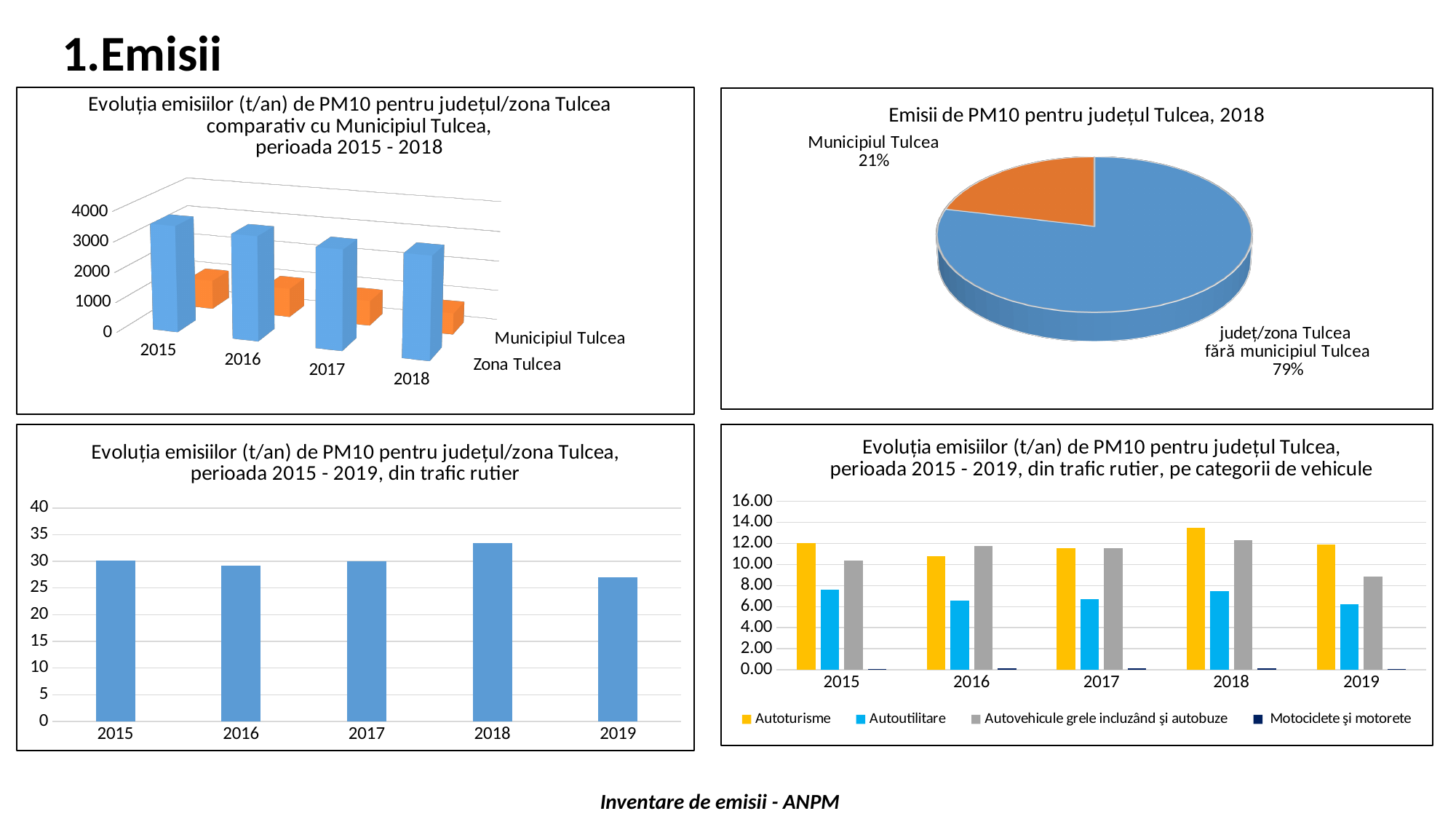
In the top-left chart 'Evoluția emisiilor (t/an) de PM10 pentru județul/zona Tulcea comparativ cu Municipiul Tulcea, perioada 2015 - 2018', which series is larger in 2015, Zona Tulcea or Municipiul Tulcea? Zona Tulcea In the bottom-right chart 'Evoluția emisiilor (t/an) de PM10 pentru județul Tulcea, perioada 2015 - 2019, din trafic rutier, pe categorii de vehicule', how many series does the legend list? 4 In the bottom-right chart 'Evoluția emisiilor (t/an) de PM10 pentru județul Tulcea, perioada 2015 - 2019, din trafic rutier, pe categorii de vehicule', is the Autoutilitare value for 2016 greater or less than 8.00? less In the pie chart 'Emisii de PM10 pentru județul Tulcea, 2018', what share does Municipiul Tulcea have? 21% In the pie chart 'Emisii de PM10 pentru județul Tulcea, 2018', what share does 'județ/zona Tulcea fără municipiul Tulcea' have? 79% In the pie chart 'Emisii de PM10 pentru județul Tulcea, 2018', how many slices are there? 2 In the bottom-right chart 'Evoluția emisiilor (t/an) de PM10 pentru județul Tulcea, perioada 2015 - 2019, din trafic rutier, pe categorii de vehicule', in which year is the Autoturisme value highest? 2018 In the bottom-left chart 'Evoluția emisiilor (t/an) de PM10 pentru județul/zona Tulcea, perioada 2015 - 2019, din trafic rutier', is the value for 2018 greater or less than 30? greater In the bottom-left chart 'Evoluția emisiilor (t/an) de PM10 pentru județul/zona Tulcea, perioada 2015 - 2019, din trafic rutier', which year has the lowest value? 2019 In the bottom-left chart 'Evoluția emisiilor (t/an) de PM10 pentru județul/zona Tulcea, perioada 2015 - 2019, din trafic rutier', how many years are shown on the x axis? 5 In the bottom-left chart 'Evoluția emisiilor (t/an) de PM10 pentru județul/zona Tulcea, perioada 2015 - 2019, din trafic rutier', which year has the highest value? 2018 In the top-left chart 'Evoluția emisiilor (t/an) de PM10 pentru județul/zona Tulcea comparativ cu Municipiul Tulcea, perioada 2015 - 2018', do the Zona Tulcea values rise or fall from 2015 to 2018? fall